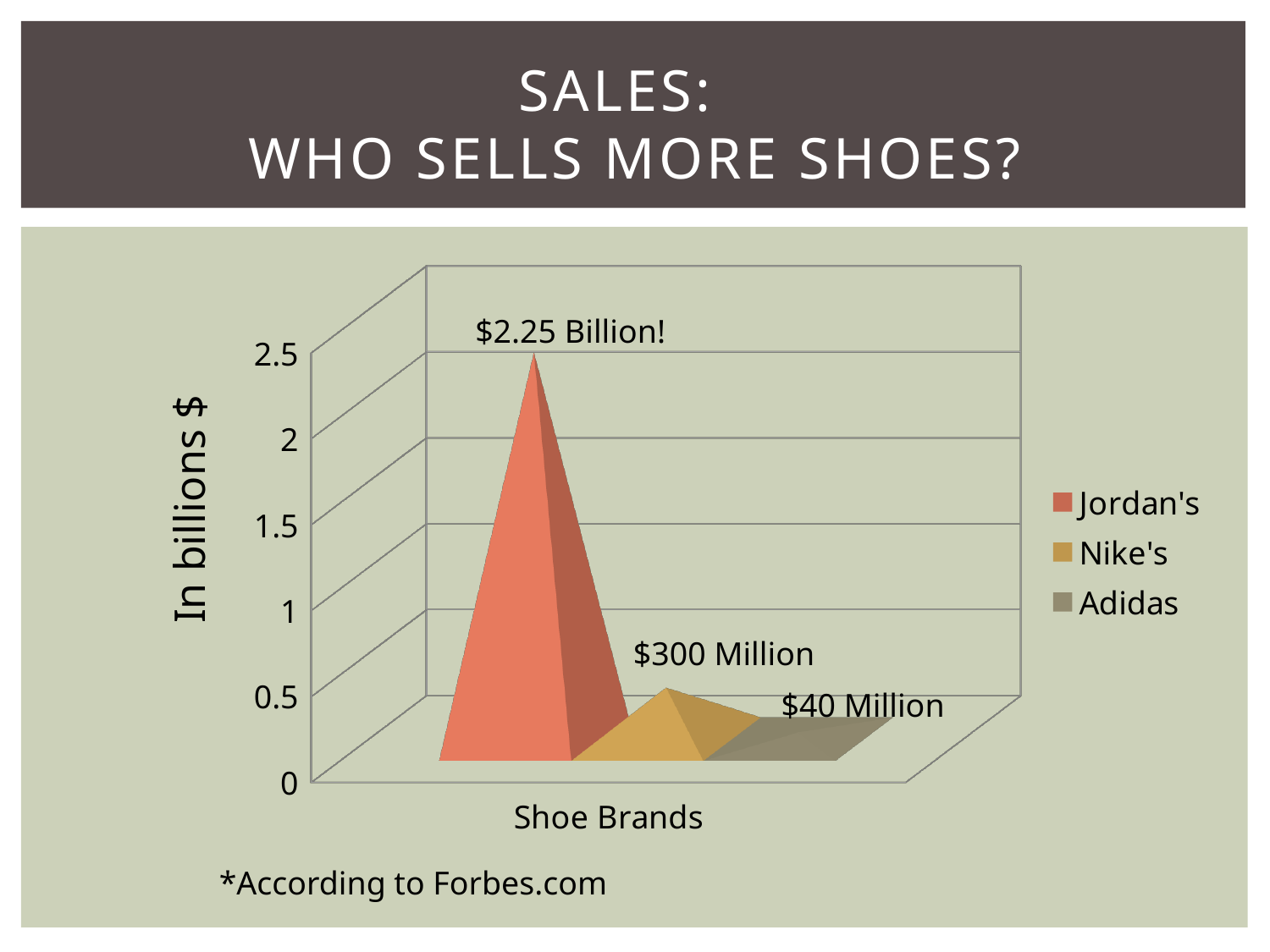
Which has higher sales, Nike's or Adidas? Nike's Is the value for Nike's greater or less than 0.5 on the axis? less What is the difference between Nike's sales and Adidas sales? $260 Million What is the label of the horizontal axis? Shoe Brands How many series does the legend list? 3 Which brand has the highest sales? Jordan's Is the value for Jordan's greater or less than 2 on the axis? greater What is the label of the vertical axis? In billions $ Which brand has the lowest sales? Adidas What are the sales for Nike's according to the data label? $300 Million What are the sales for Adidas according to the data label? $40 Million What are the sales for Jordan's according to the data label? $2.25 Billion